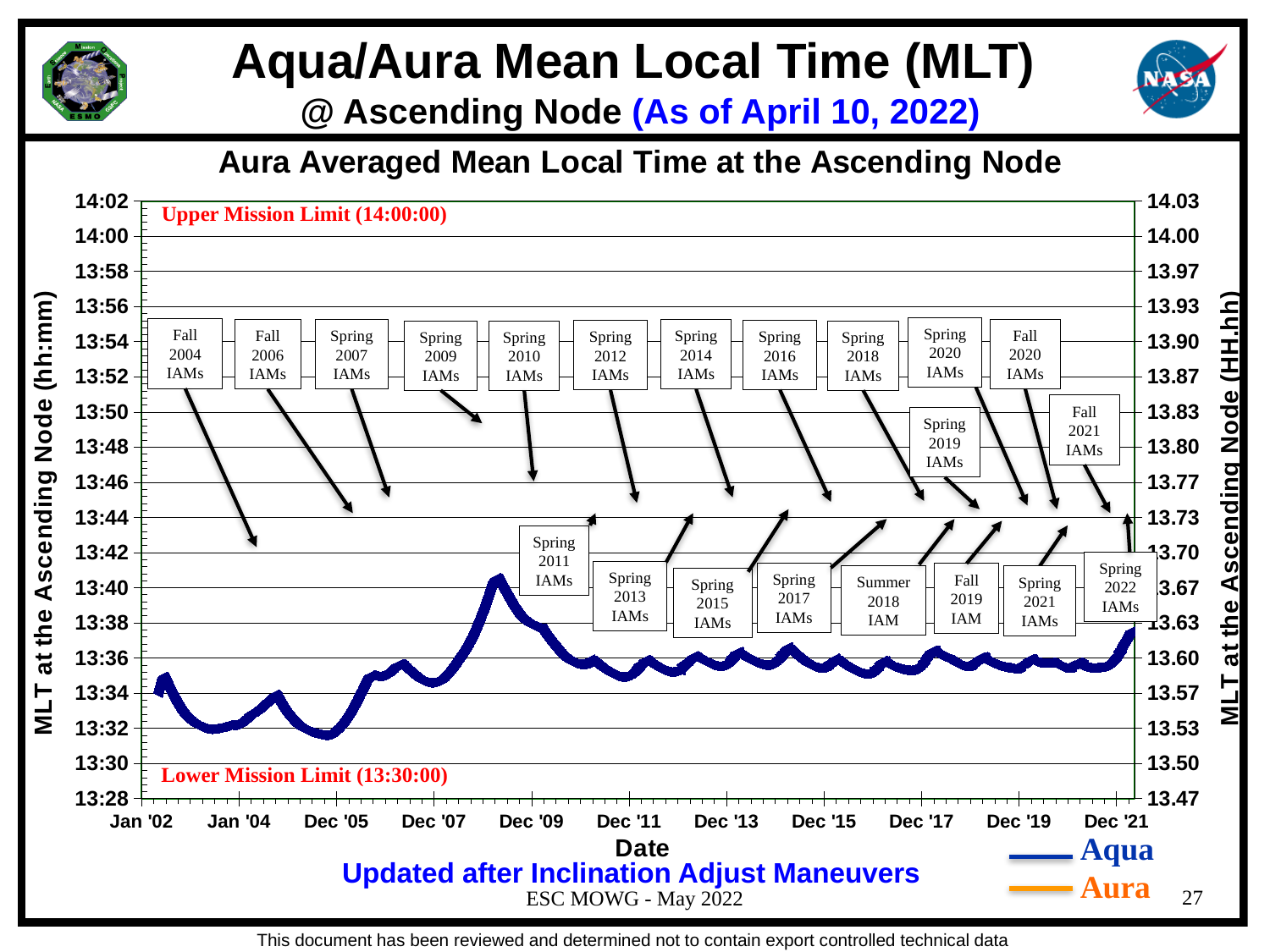
How many series does the legend list? 2 Between Dec '07 and Dec '09, does the line rise or fall? rise What kind of chart is shown on the slide? line chart Is the highest value reached by the line anywhere on the chart greater or less than 13:42? less Is the lowest value of the line around Dec '05 greater or less than 13:34? less What is the title of the chart? Aura Averaged Mean Local Time at the Ascending Node Between Jan '02 and Dec '05, does the line overall rise or fall? fall Which series is drawn in blue according to the legend? Aqua What value is given for the Upper Mission Limit on the chart? 14:00:00 Is the peak value of the line reached shortly before Dec '09 greater or less than 13:38? greater What value is given for the Lower Mission Limit on the chart? 13:30:00